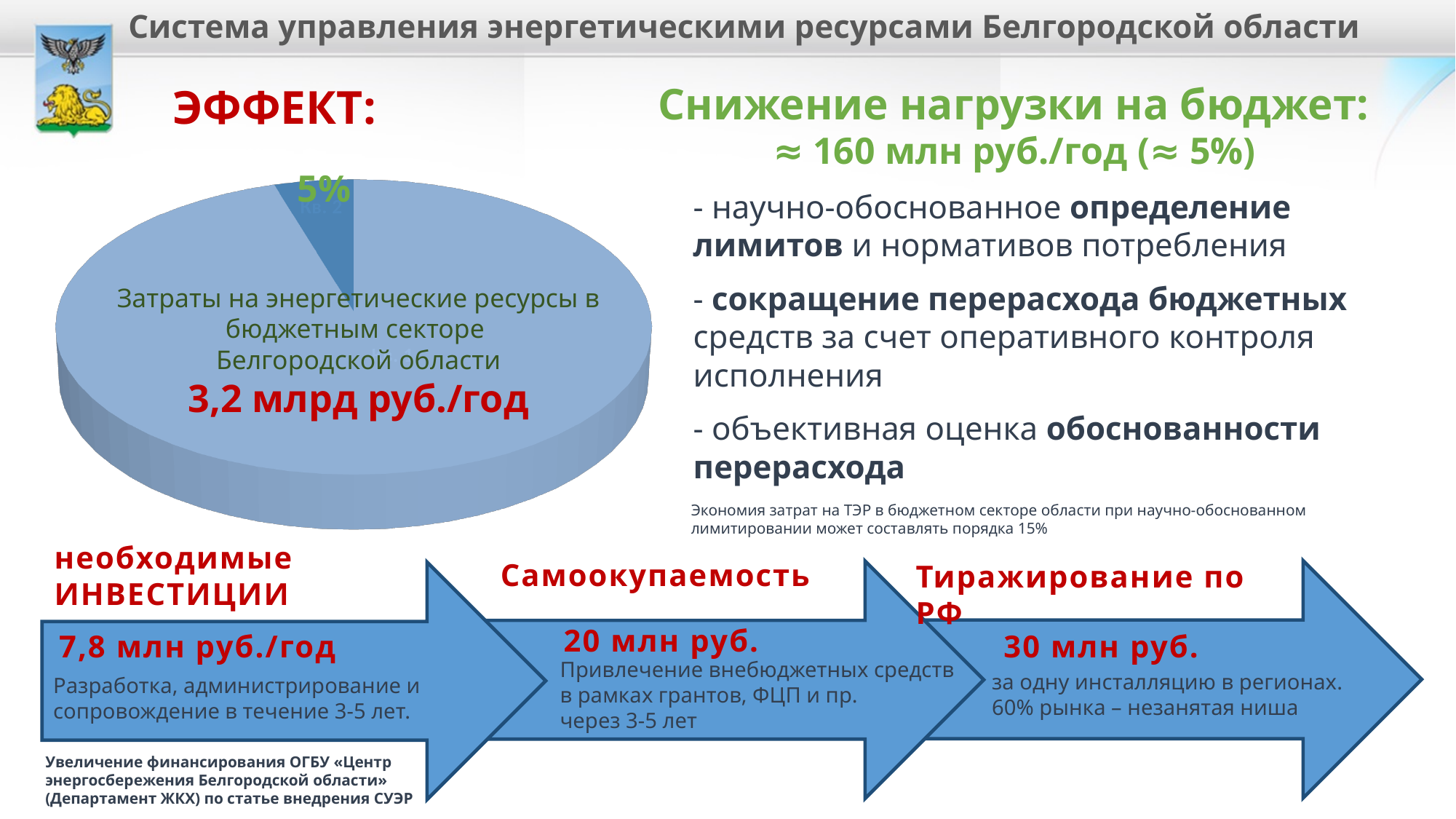
How many slices does the pie chart have? 2 Is the small slice of the pie chart greater or less than 10% of the pie? less What percentage is printed on the small slice of the pie chart? 5% What does the text inside the large slice of the pie chart say the chart represents? Затраты на энергетические ресурсы в бюджетным секторе Белгородской области Which slice of the pie chart is larger: the one labelled 5% or the one labelled 3,2 млрд руб./год? the one labelled 3,2 млрд руб./год Is the large slice of the pie chart greater or less than 50% of the pie? greater What annual value is printed inside the large slice of the pie chart? 3,2 млрд руб./год What kind of chart is shown on the left of the slide? pie chart Which slice of the pie chart is drawn in a darker blue, the small one or the large one? the small one